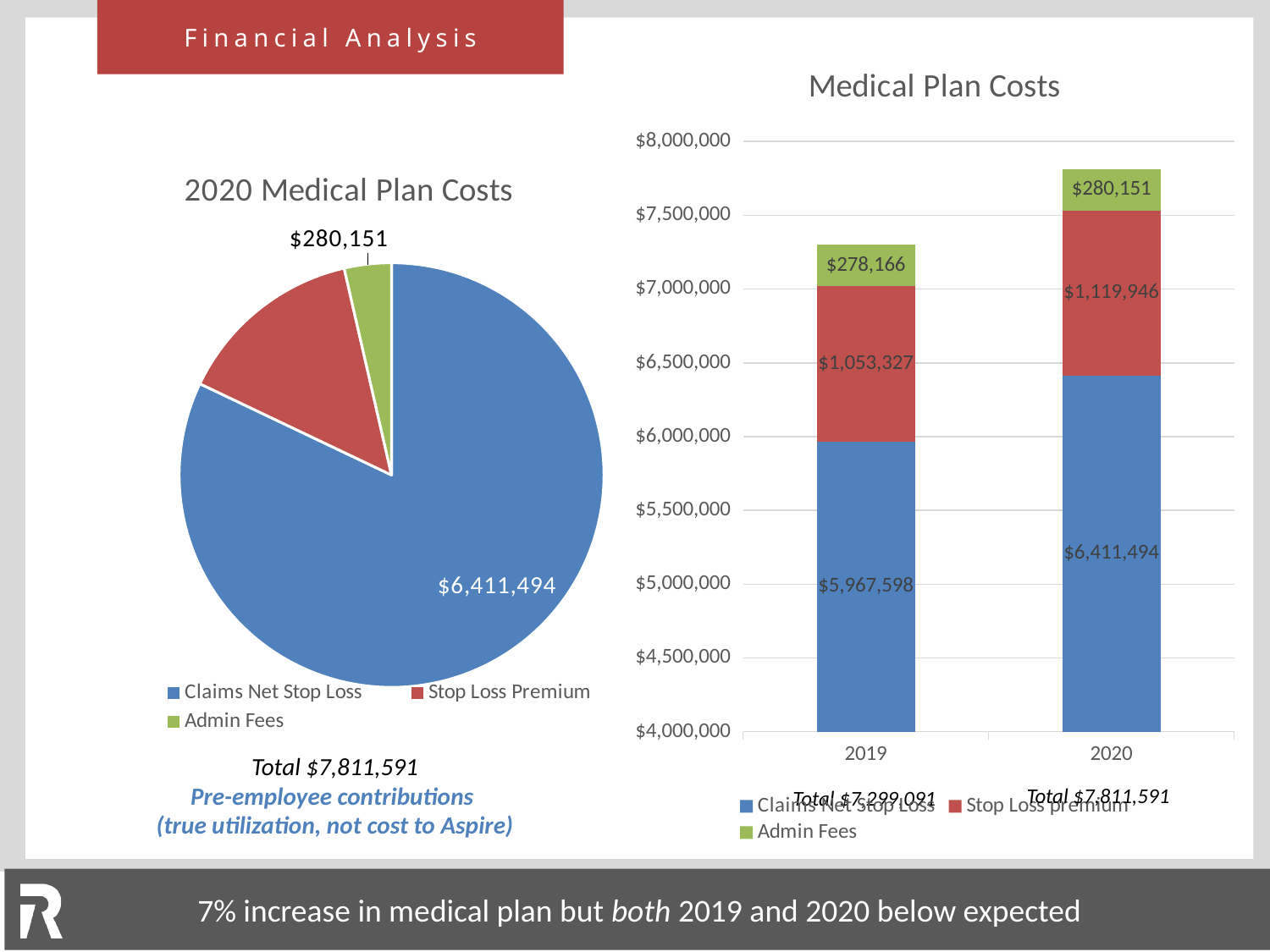
In the Medical Plan Costs bar chart, what is the difference between the 2020 and 2019 Claims Net Stop Loss values? $443,896 What kind of chart is the Medical Plan Costs chart on the right? Stacked bar chart In the Medical Plan Costs bar chart, what is the difference between the 2020 total and the 2019 total? $512,500 In the Medical Plan Costs bar chart, which year has the larger Stop Loss Premium, 2019 or 2020? 2020 How many slices does the 2020 Medical Plan Costs pie chart have? 3 In the Medical Plan Costs bar chart, what is the Stop Loss Premium value for 2020? $1,119,946 In the Medical Plan Costs bar chart, what is the Claims Net Stop Loss value for 2019? $5,967,598 In the 2020 Medical Plan Costs pie chart, which category has the largest slice? Claims Net Stop Loss In the Medical Plan Costs bar chart, what is the Admin Fees value for 2019? $278,166 In the Medical Plan Costs bar chart, what is the total for the 2020 stacked bar? $7,811,591 In the 2020 Medical Plan Costs pie chart, what is the value of the Claims Net Stop Loss slice? $6,411,494 How many series does the legend of the Medical Plan Costs bar chart list? 3